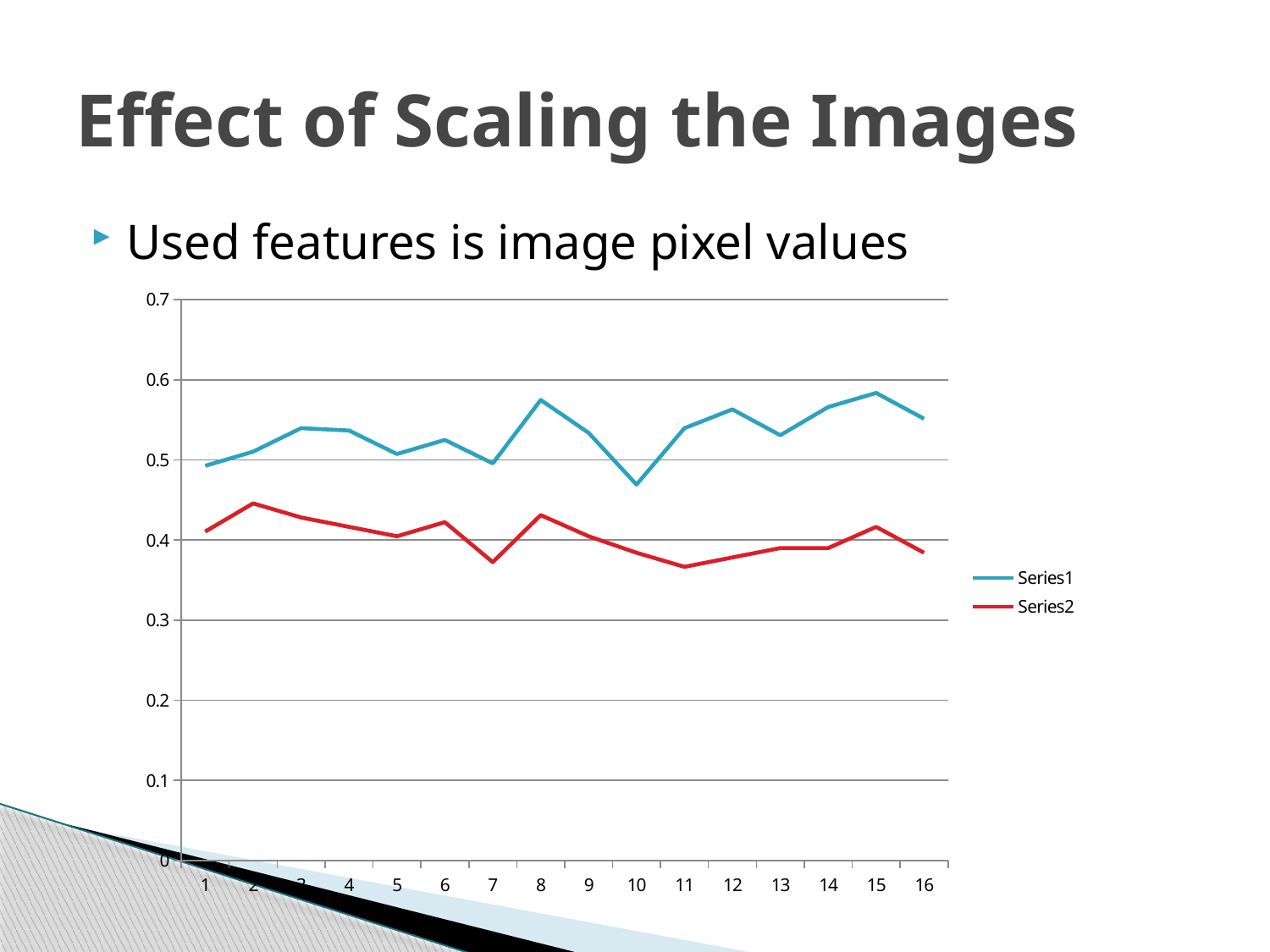
What kind of chart is shown on the slide? line chart Is the value of Series1 at point 10 greater or less than 0.5? less Which series is plotted in red? Series2 Is the value of Series1 at point 8 greater or less than 0.5? greater At point 5, which series has the larger value, Series1 or Series2? Series1 For Series1, which is larger: the value at point 8 or the value at point 10? point 8 What are the names of the two series in the legend? Series1 and Series2 How many points are plotted along the x axis for each series? 16 At which x-axis point does Series1 reach its lowest value? 10 Is the value of Series2 at point 11 greater or less than 0.4? less How many series does the legend list? 2